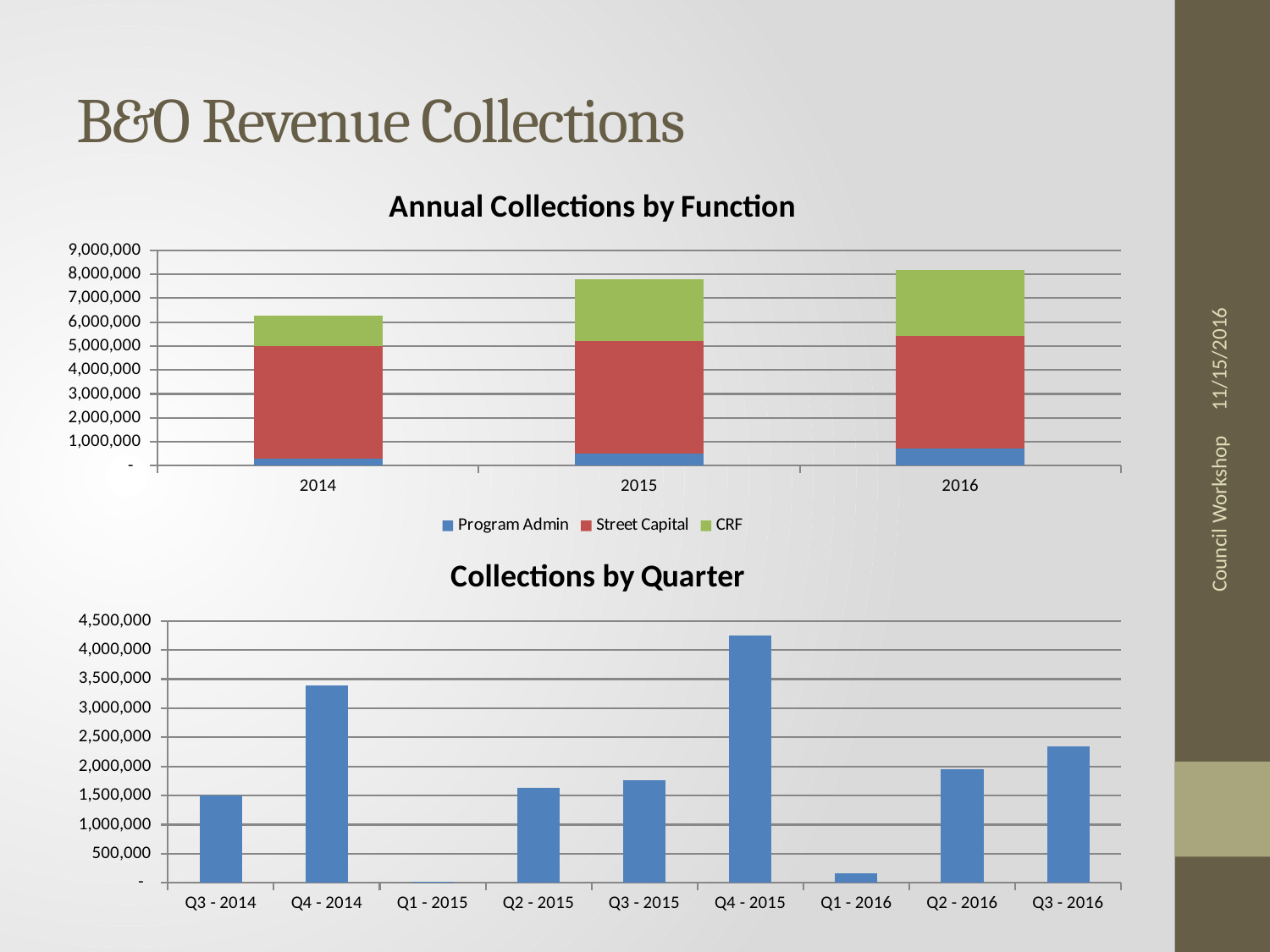
In the "Annual Collections by Function" chart, which series is shown in red? Street Capital In the "Collections by Quarter" chart, which quarter has the highest collections? Q4 - 2015 In the "Annual Collections by Function" chart, which year has the lowest total collections? 2014 In the "Annual Collections by Function" chart, is the total for 2015 greater or less than 7,000,000? greater In the "Annual Collections by Function" chart, how many series does the legend list? 3 In the "Annual Collections by Function" chart, is the total for 2014 greater or less than 7,000,000? less In the "Collections by Quarter" chart, how many quarters are shown on the x axis? 9 What kind of chart is "Collections by Quarter"? bar chart In the "Collections by Quarter" chart, which is larger, Q4 - 2014 or Q3 - 2016? Q4 - 2014 In the "Annual Collections by Function" chart, do total collections rise or fall from 2014 to 2016? rise In the "Collections by Quarter" chart, is the value for Q4 - 2014 greater or less than 3,000,000? greater In the "Collections by Quarter" chart, which quarter has the lowest collections? Q1 - 2015